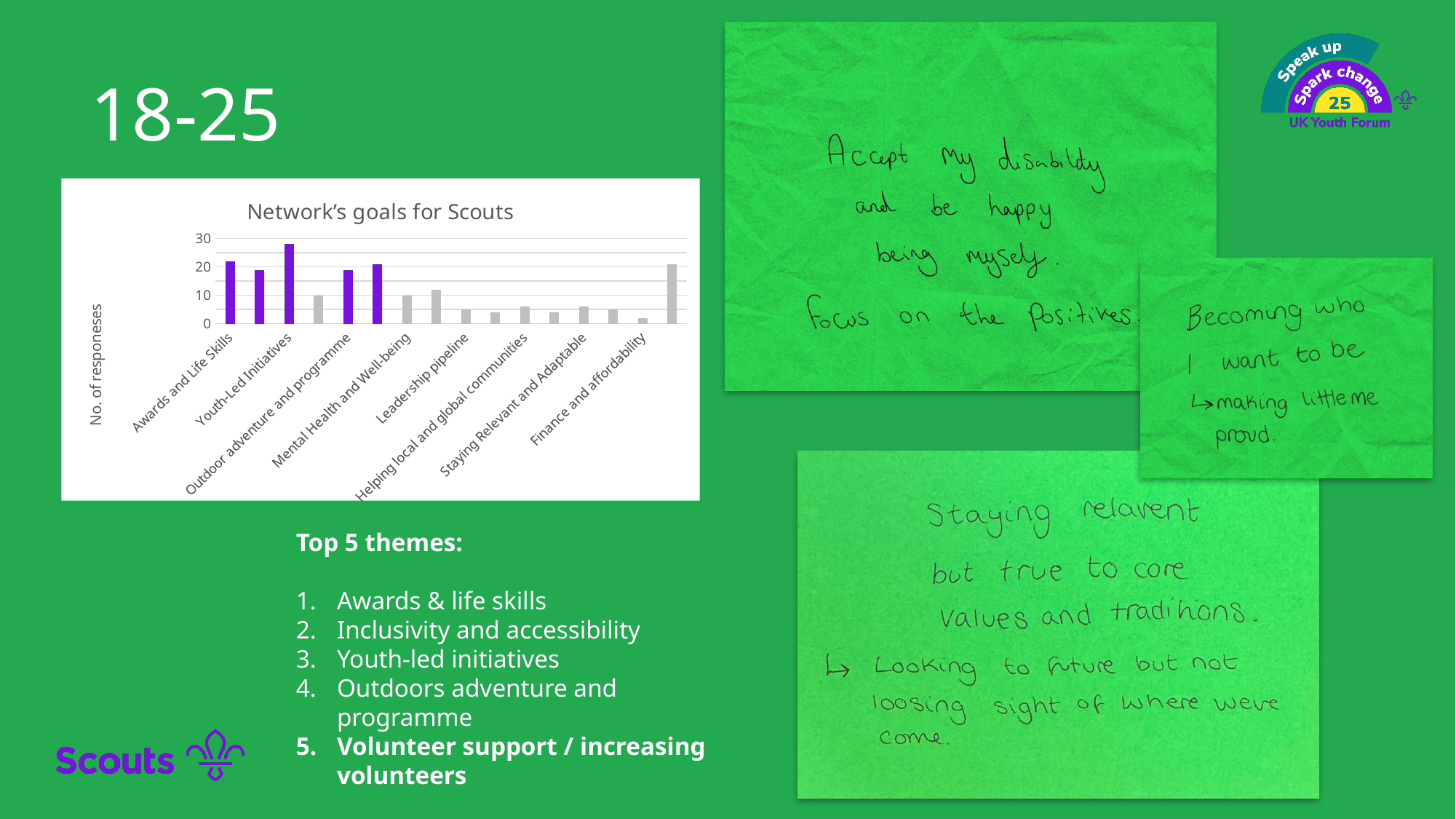
What is the label on the vertical axis of the chart? No. of responses Which has more responses, Youth-Led Initiatives or Awards and Life Skills? Youth-Led Initiatives Which labelled category has the lowest number of responses in the chart? Finance and affordability Is the value for Awards and Life Skills greater or less than 20? greater Is the value for Leadership pipeline greater or less than 10? less Is the value for Mental Health and Well-being greater or less than 20? less Which has more responses, Outdoor adventure and programme or Helping local and global communities? Outdoor adventure and programme What type of chart is shown on the slide? Bar chart Which category has the highest number of responses in the chart? Youth-Led Initiatives What is the title of the chart? Network's goals for Scouts